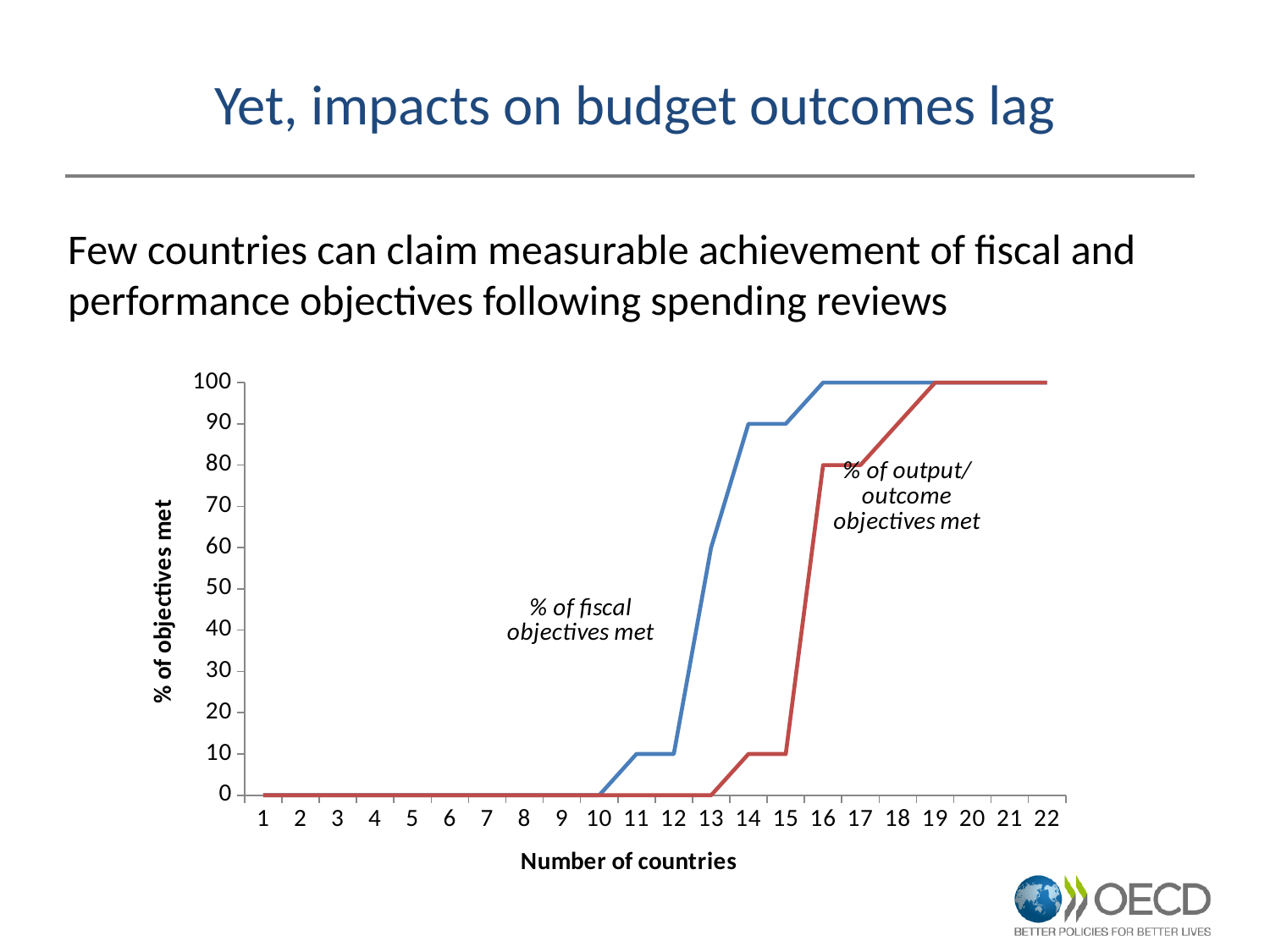
Do the values of the '% of fiscal objectives met' line rise or fall as the number of countries increases? rise What is the title of the x axis of the chart? Number of countries At 16 countries, which line is higher: '% of fiscal objectives met' or '% of output/outcome objectives met'? % of fiscal objectives met How many points are shown along the x axis of the chart? 22 What is the value of the '% of output/outcome objectives met' line at 14 countries? 10 How many series are plotted on the chart? 2 Is the value of the '% of fiscal objectives met' line at 13 countries greater or less than 50? greater What kind of chart is shown on the slide? line chart What is the value of the '% of fiscal objectives met' line at 14 countries? 90 What is the value of the '% of fiscal objectives met' line at 11 countries? 10 What is the value of the '% of output/outcome objectives met' line at 16 countries? 80